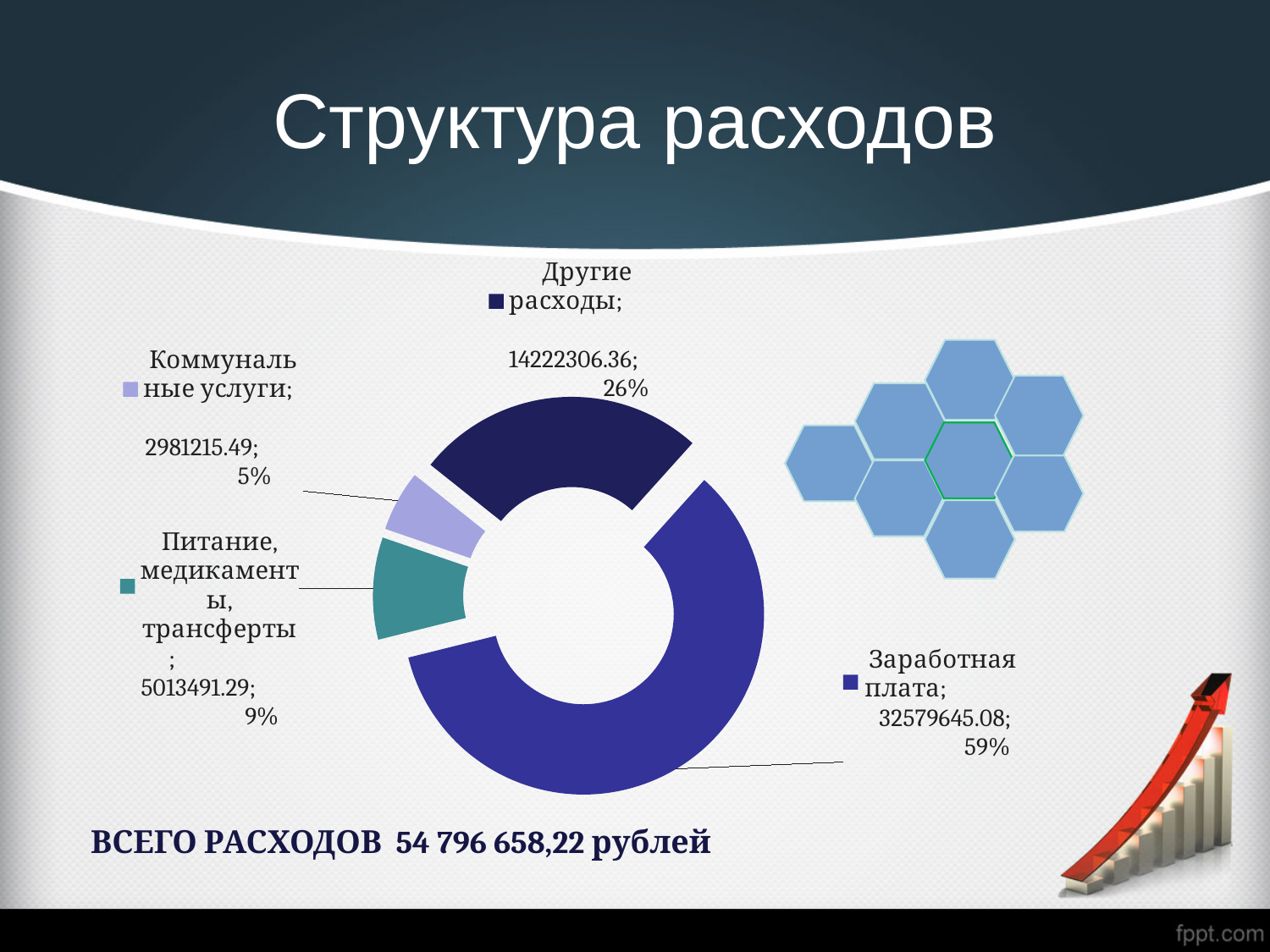
What is the difference in percentage points between Другие расходы and Коммунальные услуги? 21 What is the value shown for Коммунальные услуги? 2981215.49 Which category has the largest share of expenses? Заработная плата What share of expenses does Заработная плата account for? 59% How many categories are shown in the chart? 4 Which category has the smallest share of expenses? Коммунальные услуги What percentage is shown for Питание, медикаменты, трансферты? 9% What kind of chart is shown on the slide? doughnut chart What is the difference between the values for Заработная плата and Другие расходы? 18357338.72 What is the title of the slide containing the chart? Структура расходов Which is larger, Другие расходы or Питание, медикаменты, трансферты? Другие расходы What is the value shown for Другие расходы? 14222306.36